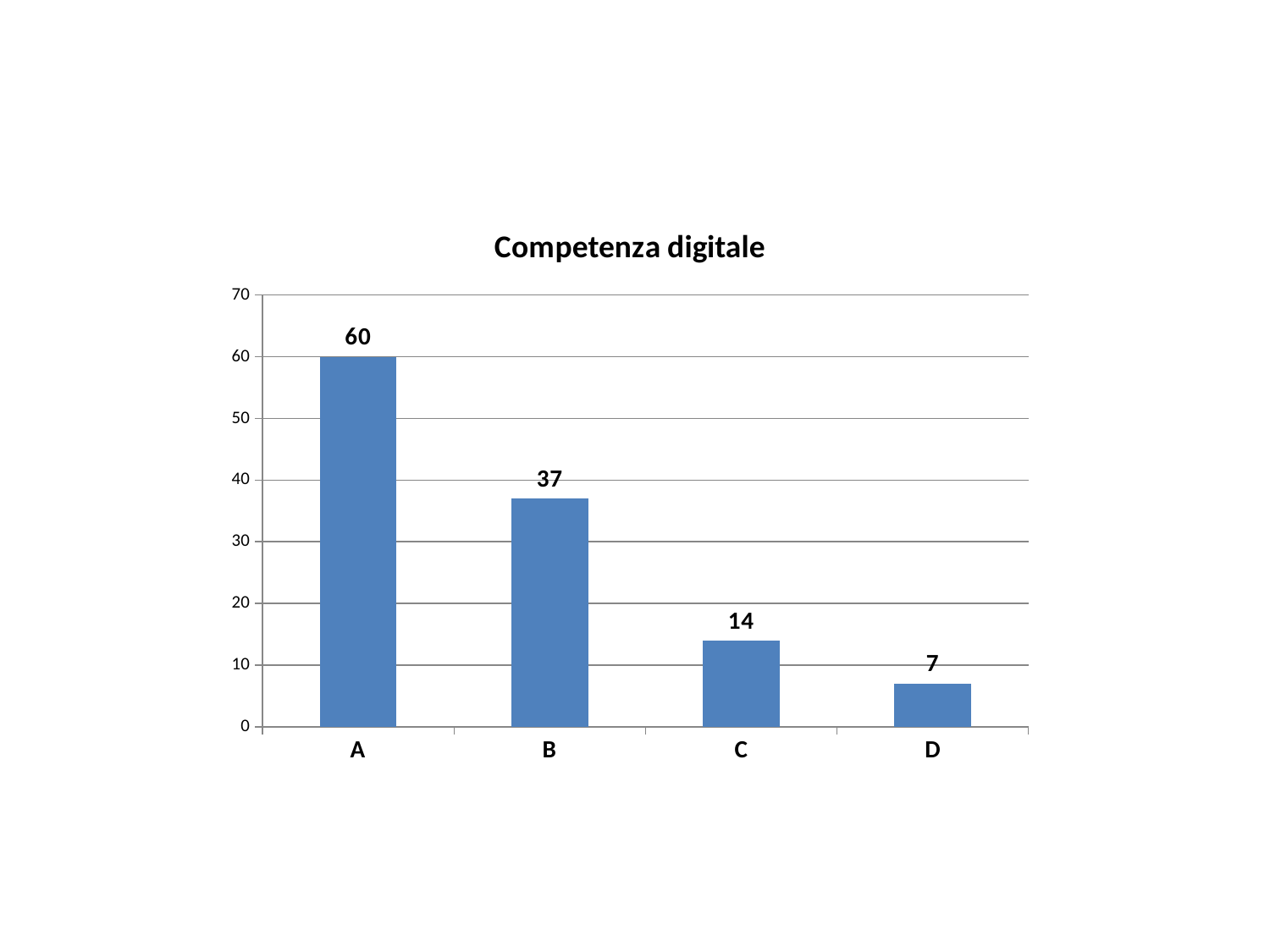
What is the value for category B? 37 Which category has the highest value? A What is the title of the chart? Competenza digitale What kind of chart is shown on the slide? bar chart Which is larger, the value for C or the value for D? C Is the value for B greater or less than 40? less What is the value for category C? 14 Which category has the lowest value? D How many categories are shown on the x axis? 4 What is the value for category D? 7 What is the difference between the values for A and B? 23 What is the value for category A? 60